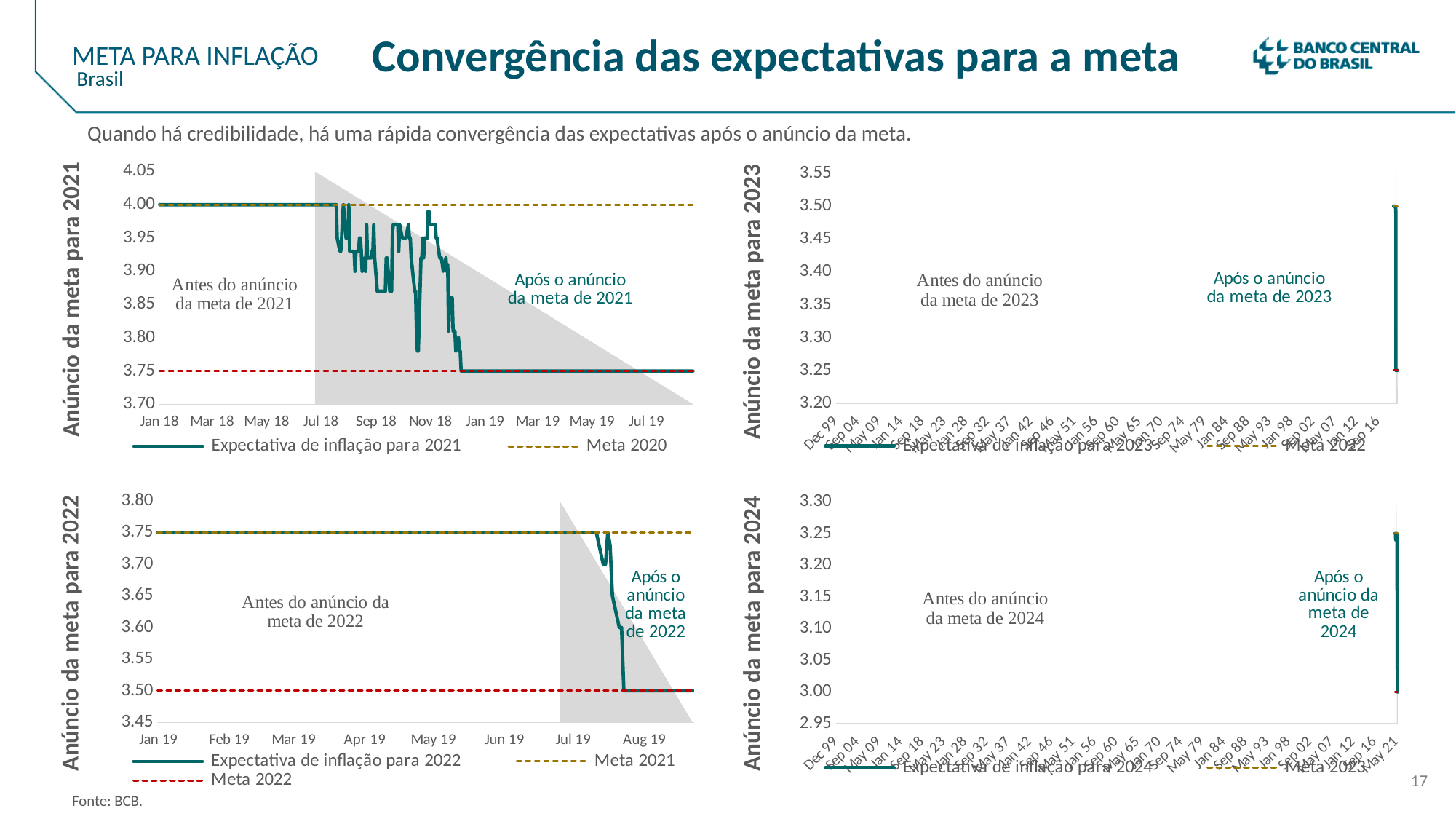
How many charts are shown on the slide? 4 In the 'Anúncio da meta para 2022' chart, does the 'Expectativa de inflação para 2022' line rise or fall from Jan 19 to Aug 19? fall In the 'Anúncio da meta para 2022' chart, is the value of 'Expectativa de inflação para 2022' at Jan 19 greater or less than 3.60? greater In the 'Anúncio da meta para 2022' chart, what value does the dashed 'Meta 2022' line sit at? 3.50 In the 'Anúncio da meta para 2021' chart, is the value of 'Expectativa de inflação para 2021' at Jul 19 greater or less than 3.80? less What is the title of the slide? Convergência das expectativas para a meta In the 'Anúncio da meta para 2022' chart, what value does the dashed 'Meta 2021' line sit at? 3.75 In the 'Anúncio da meta para 2021' chart, does the 'Expectativa de inflação para 2021' line rise or fall from Jan 18 to Jul 19? fall In the 'Anúncio da meta para 2022' chart, how many series does the legend list? 3 What kind of chart is the 'Anúncio da meta para 2021' chart? line chart In the 'Anúncio da meta para 2021' chart, what value does the dashed 'Meta 2020' line sit at? 4.00 In the 'Anúncio da meta para 2021' chart, how many series does the legend list? 2